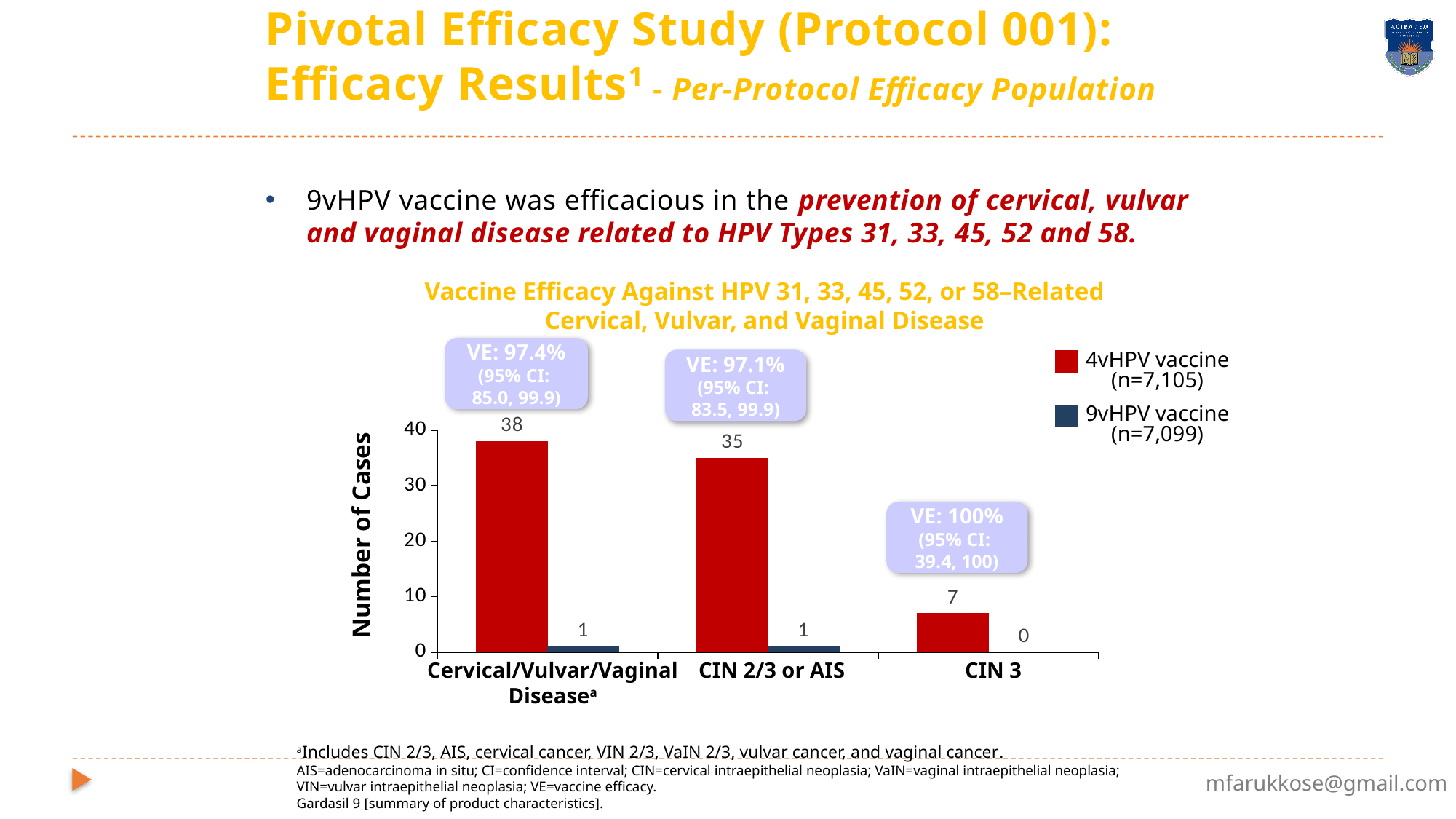
How many cases of Cervical/Vulvar/Vaginal Disease were there in the 4vHPV vaccine group? 38 How many cases of CIN 2/3 or AIS were there in the 9vHPV vaccine group? 1 How many cases of CIN 3 were there in the 4vHPV vaccine group? 7 What is the difference in the number of cases between the 4vHPV and 9vHPV vaccine groups for CIN 2/3 or AIS? 34 What is the vaccine efficacy (VE) shown for CIN 3? 100% Which category has the lowest number of cases in the 4vHPV vaccine group? CIN 3 Which group had more cases of Cervical/Vulvar/Vaginal Disease, the 4vHPV vaccine group or the 9vHPV vaccine group? 4vHPV vaccine How many series does the chart legend list? 2 What kind of chart is shown on the slide? Bar chart Which category has the highest number of cases in the 4vHPV vaccine group? Cervical/Vulvar/Vaginal Disease How many cases of CIN 3 were there in the 9vHPV vaccine group? 0 How many categories are shown on the x axis of the chart? 3